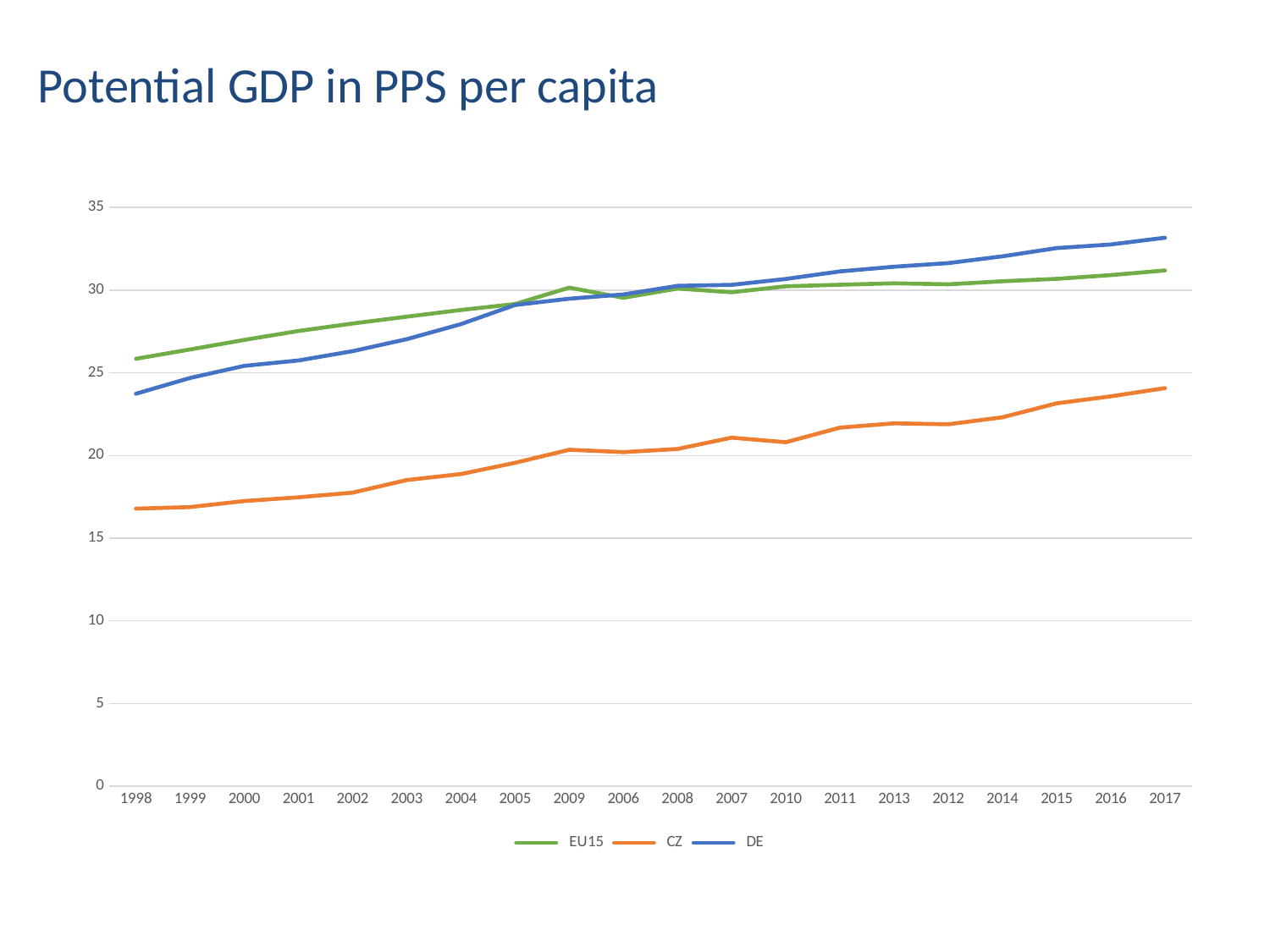
What is the title of the chart? Potential GDP in PPS per capita How many year labels are shown along the x axis? 20 At 1998, which is larger: the value for EU15 or the value for DE? EU15 Which series has the lowest values across the whole chart? CZ Does the CZ line rise or fall from 1998 to 2017? rise How many series does the legend list? 3 Is the value for DE at 2017 greater or less than 30? greater Is the value for CZ at 2017 greater or less than 25? less Is the value for CZ at 1998 greater or less than 20? less Which series has the highest value at 2017? DE What kind of chart is shown on the slide? line chart